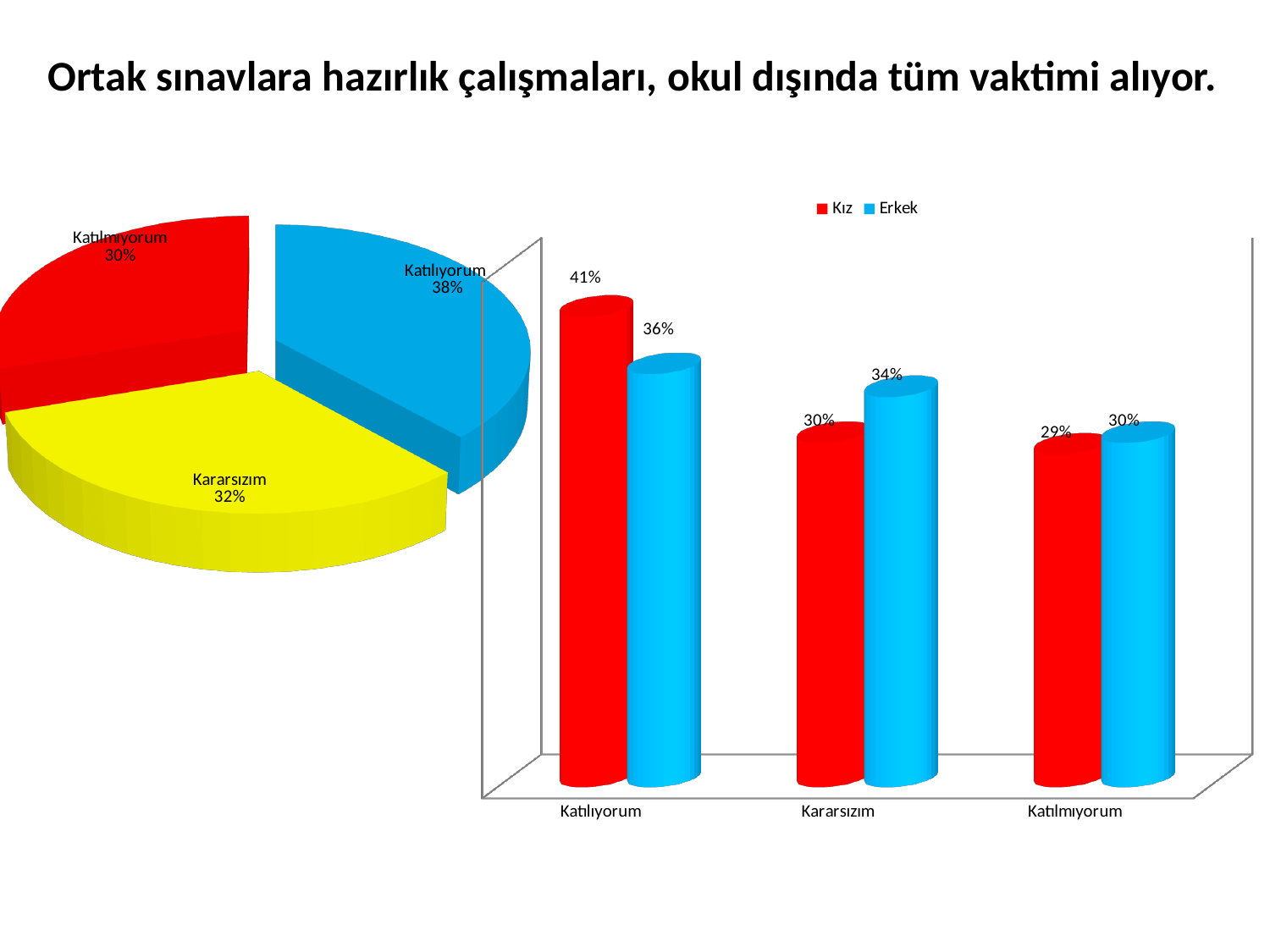
In the pie chart on the left, which slice is the smallest? Katılmıyorum In the bar chart on the right, what is the Kız value for Katılmıyorum? 29% In the bar chart on the right, which category has the highest Kız value? Katılıyorum In the bar chart on the right, how many series does the legend list? 2 In the bar chart on the right, what is the Erkek value for Kararsızım? 34% In the bar chart on the right, what is the difference between the Kız and Erkek values for Katılıyorum? 5% In the pie chart on the left, what is the value for Kararsızım? 32% In the bar chart on the right, for Kararsızım, which is larger: the Kız value or the Erkek value? Erkek What kind of chart is the chart on the right of the slide? Bar chart In the pie chart on the left, what share does the Katılıyorum slice have? 38% In the bar chart on the right, what is the Kız value for Katılıyorum? 41% In the pie chart on the left, how many slices are there? 3